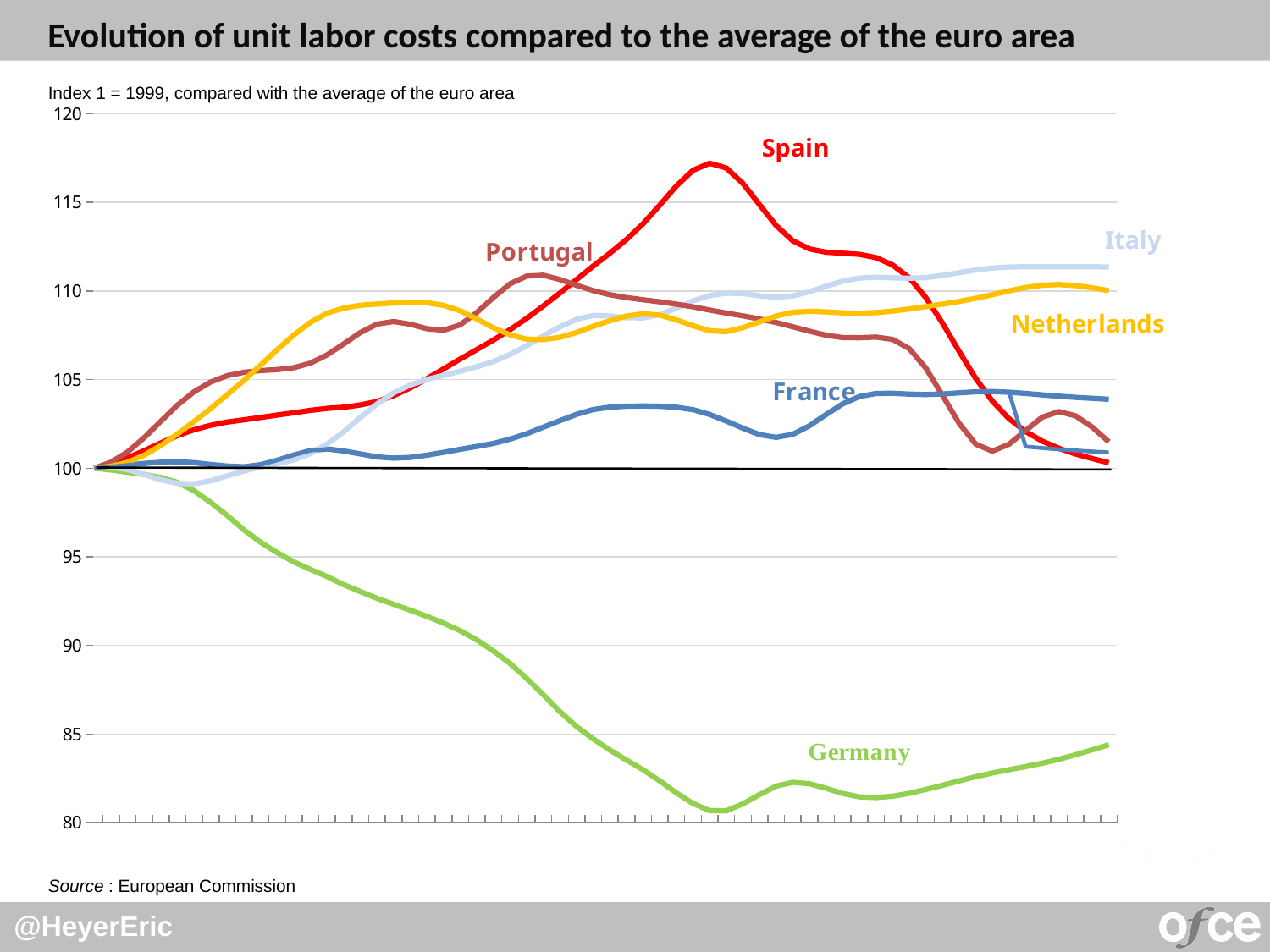
Does the Germany line overall rise or fall from the left of the chart to its lowest point? fall Which country's line stays below 100 for the whole chart after the start? Germany Which country's line reaches the highest value on the chart? Spain What is the source given for the chart? European Commission At the right end of the chart, which line is higher, Italy or Spain? Italy Which country's line falls to the lowest value on the chart? Germany Is the lowest point of the Germany line greater or less than 85? less Is the peak value of the Spain line greater or less than 115? greater Is the value of the Italy line at the right end of the chart greater or less than 110? greater What is the title of the chart? Evolution of unit labor costs compared to the average of the euro area How many countries are plotted as lines on the chart? 6 What kind of chart is shown on the slide? line chart